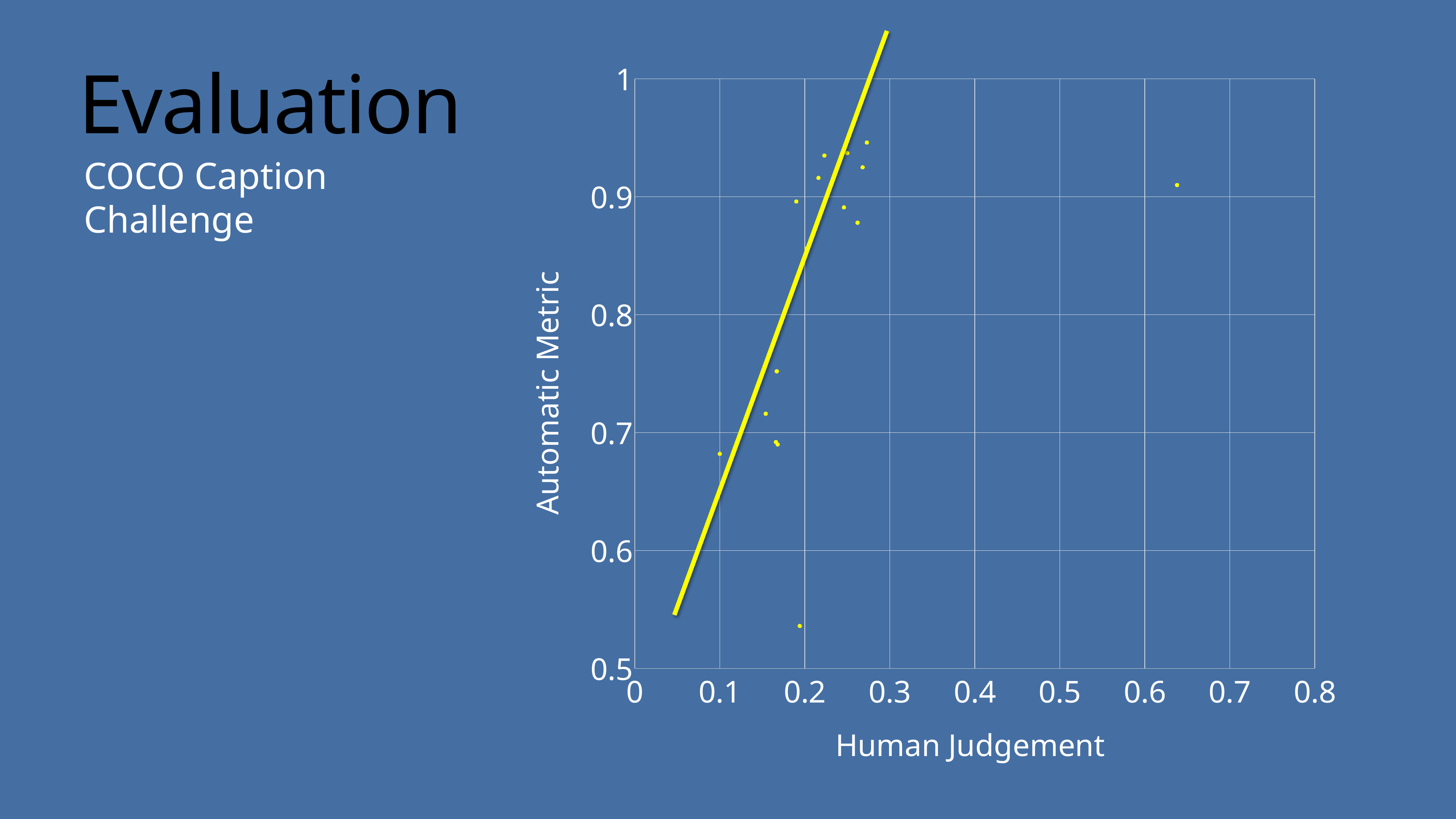
What is the lowest tick value shown on the Automatic Metric axis? 0.5 Is the Automatic Metric value of the highest point on the chart greater or less than 0.9? greater What is the label of the horizontal axis of the chart? Human Judgement What kind of chart is shown on the slide? Scatter plot What is the label of the vertical axis of the chart? Automatic Metric Is the Automatic Metric value of the lowest point on the chart greater or less than 0.6? less Is the Human Judgement value of the rightmost point on the chart greater or less than 0.5? greater As Human Judgement increases along the x axis, does the fitted trend line rise or fall? Rise What is the highest tick value shown on the Human Judgement axis? 0.8